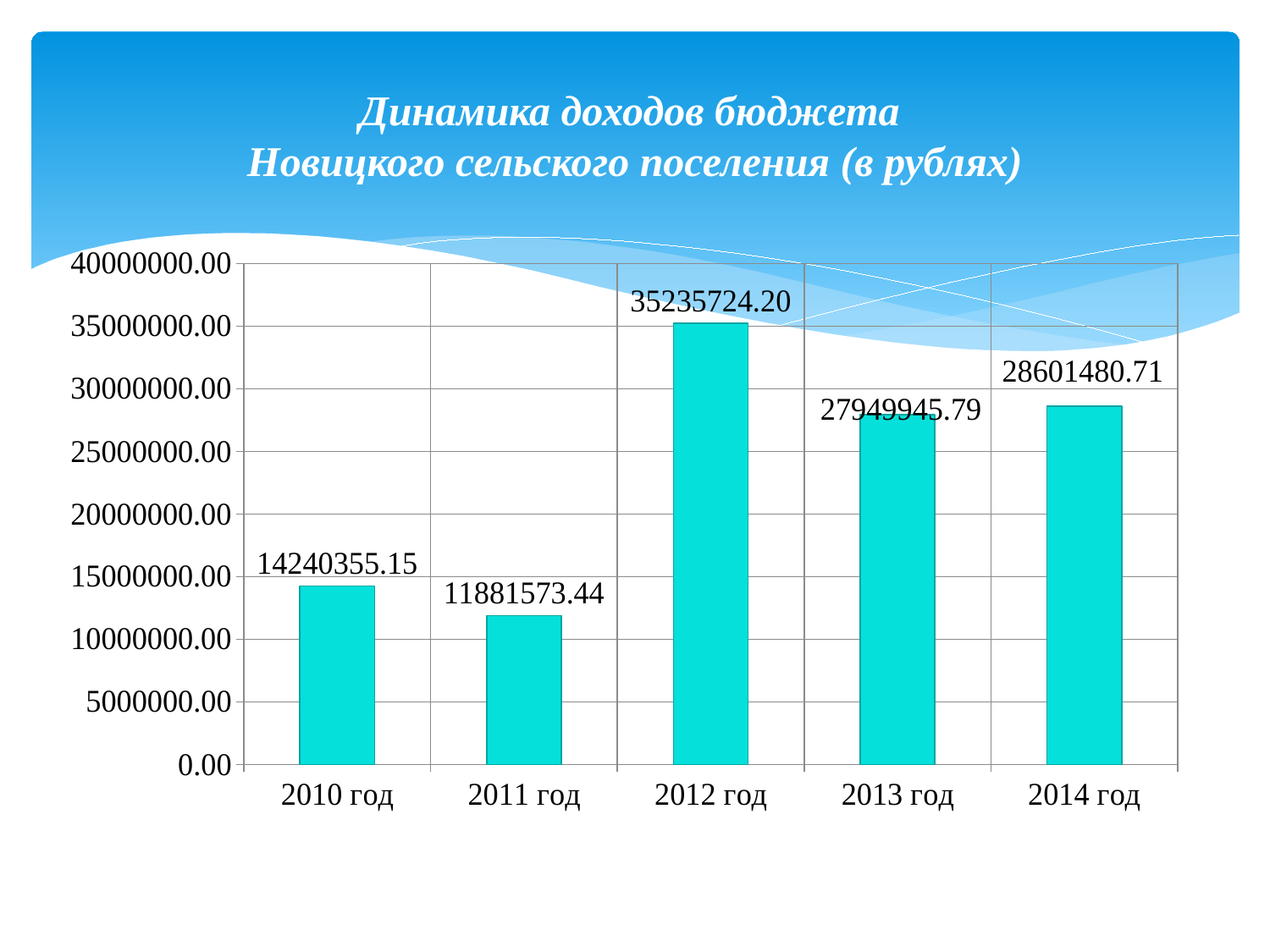
How many years are shown on the chart? 5 What is the difference between the values for 2012 год and 2011 год? 23354150.76 From 2010 год to 2011 год, does the value rise or fall? fall Is the value for 2013 год greater or less than 25000000.00? greater What is the value for 2012 год? 35235724.20 What is the value for 2010 год? 14240355.15 What is the difference between the values for 2014 год and 2013 год? 651534.92 Which is larger, the value for 2013 год or 2014 год? 2014 год Which year has the highest value? 2012 год What is the value for 2014 год? 28601480.71 Which year has the lowest value? 2011 год What kind of chart is shown on the slide? bar chart